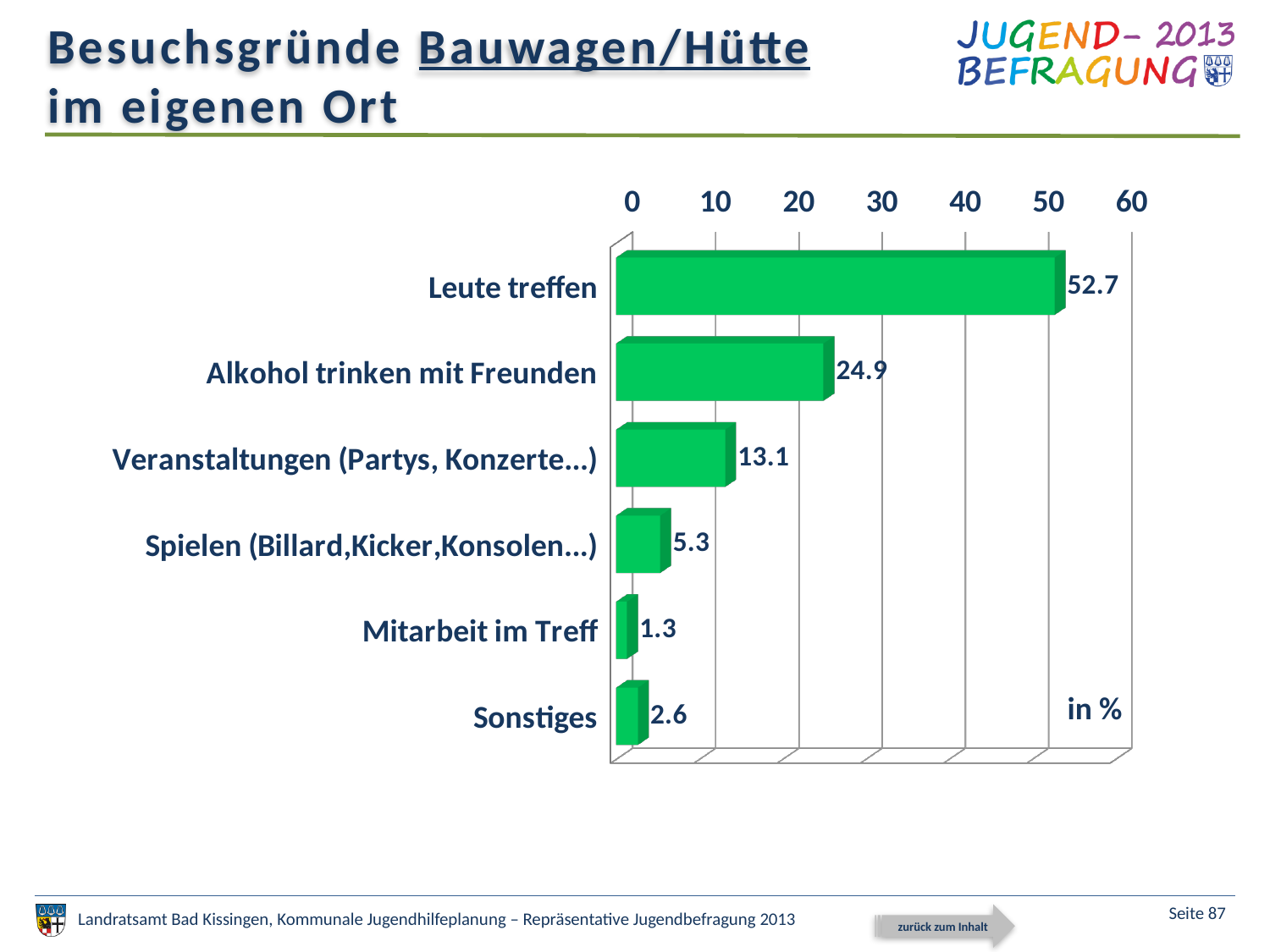
Is the value for "Alkohol trinken mit Freunden" greater or less than 20? greater What is the difference between the values for "Leute treffen" and "Alkohol trinken mit Freunden"? 27.8 What is the value for "Alkohol trinken mit Freunden"? 24.9 What is the value for "Leute treffen"? 52.7 What is the value for "Veranstaltungen (Partys, Konzerte...)"? 13.1 Which category has the lowest value? Mitarbeit im Treff How many categories are shown in the chart? 6 Which is larger, the value for "Spielen (Billard,Kicker,Konsolen...)" or the value for "Sonstiges"? Spielen (Billard,Kicker,Konsolen...) What is the value for "Mitarbeit im Treff"? 1.3 What kind of chart is shown on the slide? bar chart Which category has the highest value? Leute treffen What unit are the values in the chart given in? %